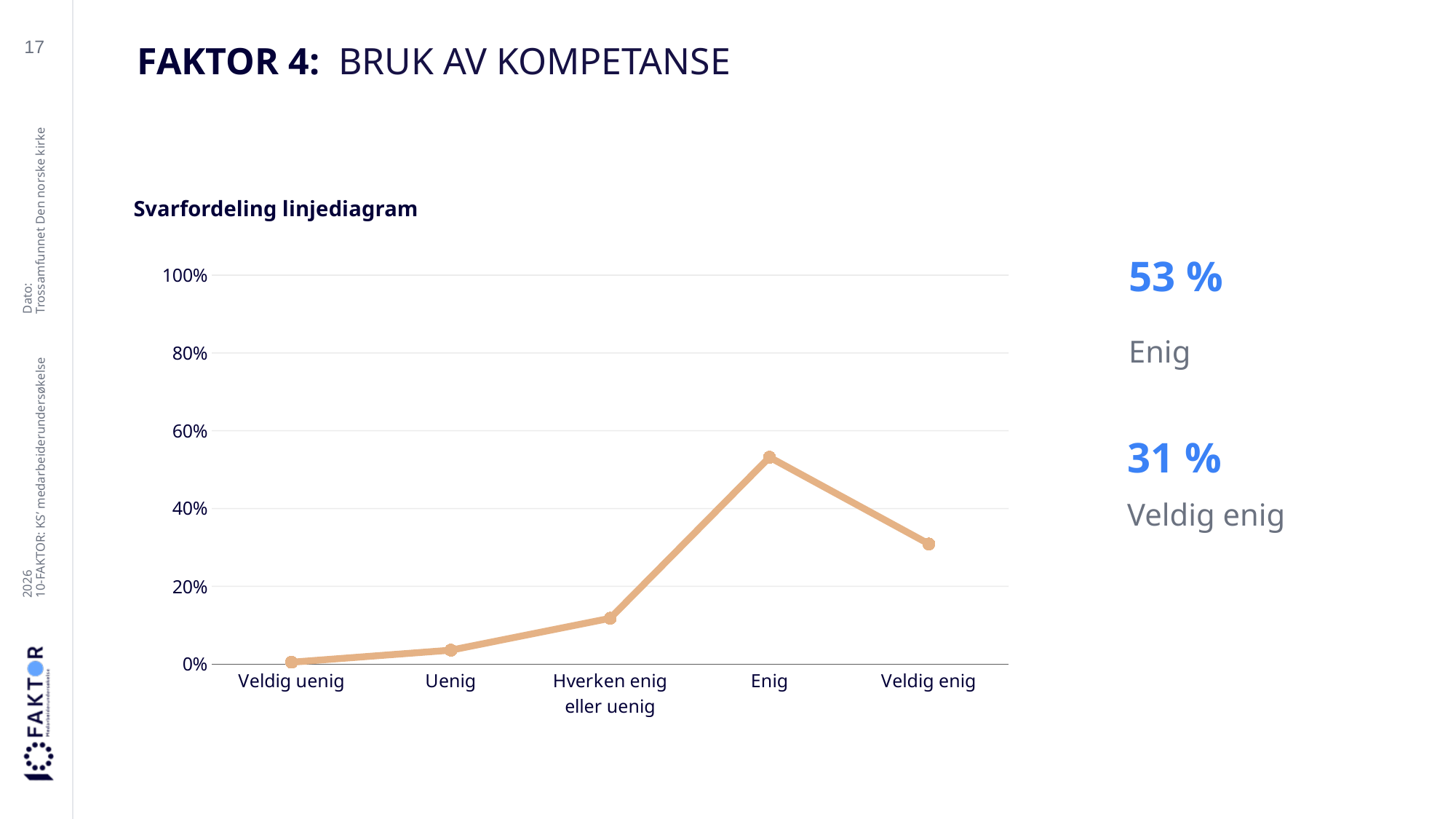
Do the values rise or fall from Veldig uenig to Enig along the x axis? rise How many categories are plotted along the x axis of the chart? 5 What is the title of the chart? Svarfordeling linjediagram Which category has the highest value in the chart? Enig Is the value for Hverken enig eller uenig greater or less than 20%? less What is the value for Enig? 53 % What is the difference between the values for Enig and Veldig enig? 22 % Is the value for Uenig greater or less than 20%? less Which is larger, the value for Enig or the value for Veldig enig? Enig What is the value for Veldig enig? 31 % Is the value for Enig greater or less than 40%? greater What kind of chart is shown on the slide? line chart